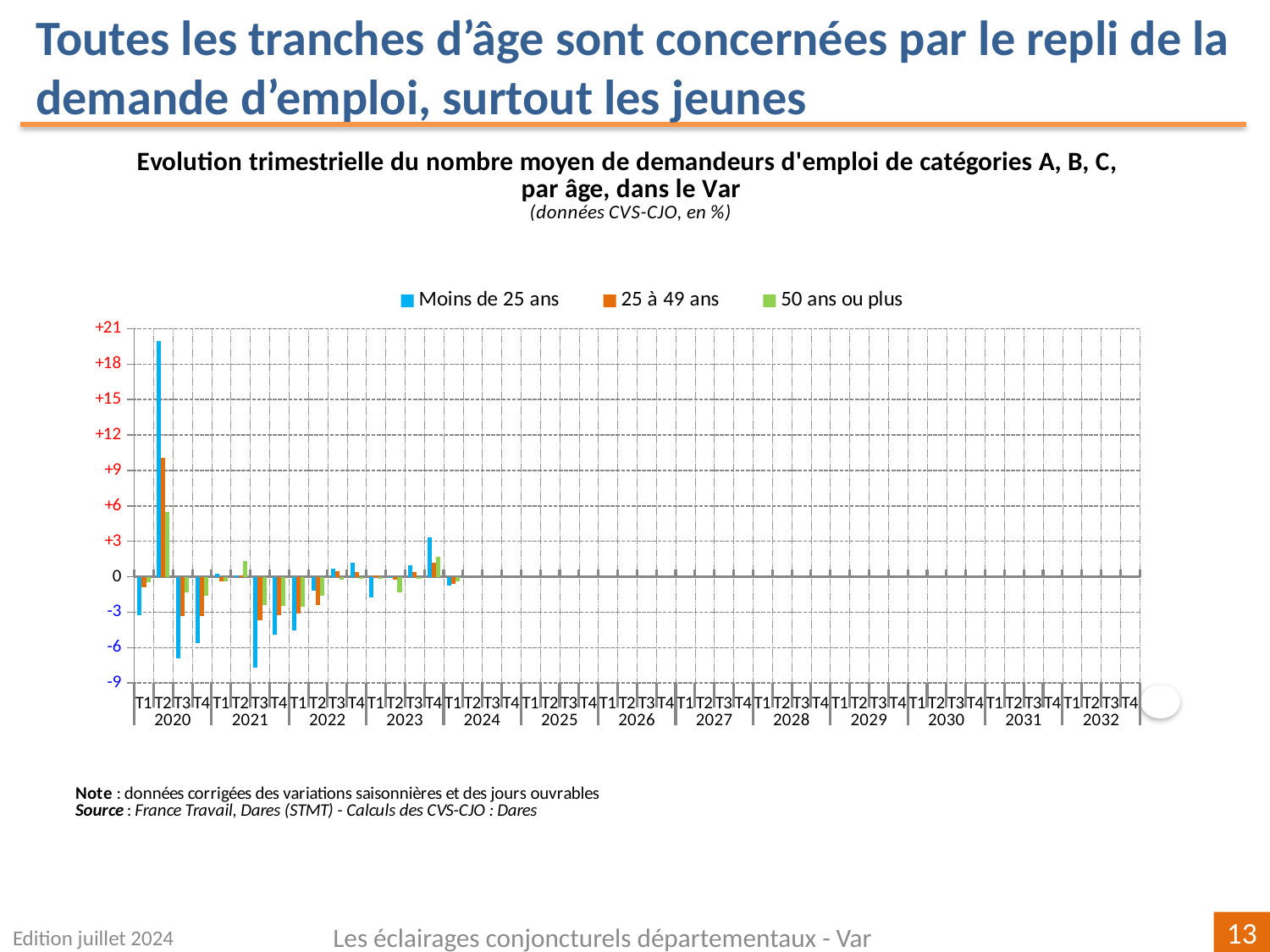
What kind of chart is shown on the slide? bar chart Which series is shown in green according to the legend? 50 ans ou plus Is the value for '50 ans ou plus' in T2 2020 greater or less than +3? greater Is the value for 'Moins de 25 ans' in T2 2020 greater or less than +18? greater Is the value for '25 à 49 ans' in T2 2020 greater or less than +6? greater In which quarter does the 'Moins de 25 ans' series reach its highest value? T2 2020 How many series does the legend list? 3 What is the highest tick value shown on the vertical axis? +21 In T2 2020, which series has the larger value: 'Moins de 25 ans' or '25 à 49 ans'? Moins de 25 ans Which series is shown in blue according to the legend? Moins de 25 ans